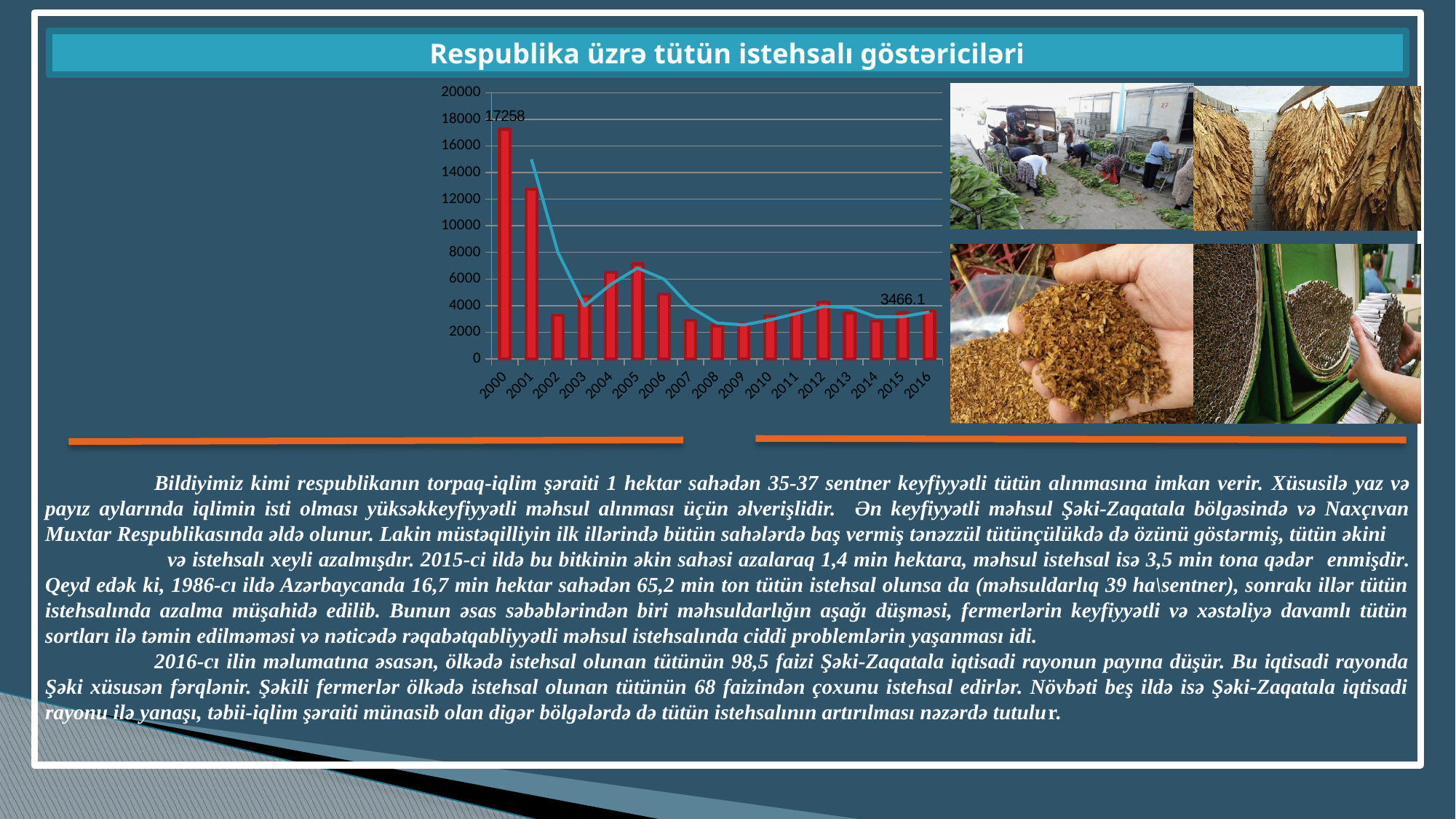
What is the value shown for 2000? 17258 How many years are shown on the x axis of the chart? 17 Which year has the highest value in the chart? 2000 Is the value for 2005 greater or less than 8000? less Is the value for 2001 greater or less than 12000? greater Do the values generally rise or fall from 2000 to 2016? fall Which year has the larger value, 2004 or 2005? 2005 Is the value for 2002 greater or less than 4000? less What kind of chart is shown on the slide? bar chart Which year has the larger value, 2000 or 2001? 2000